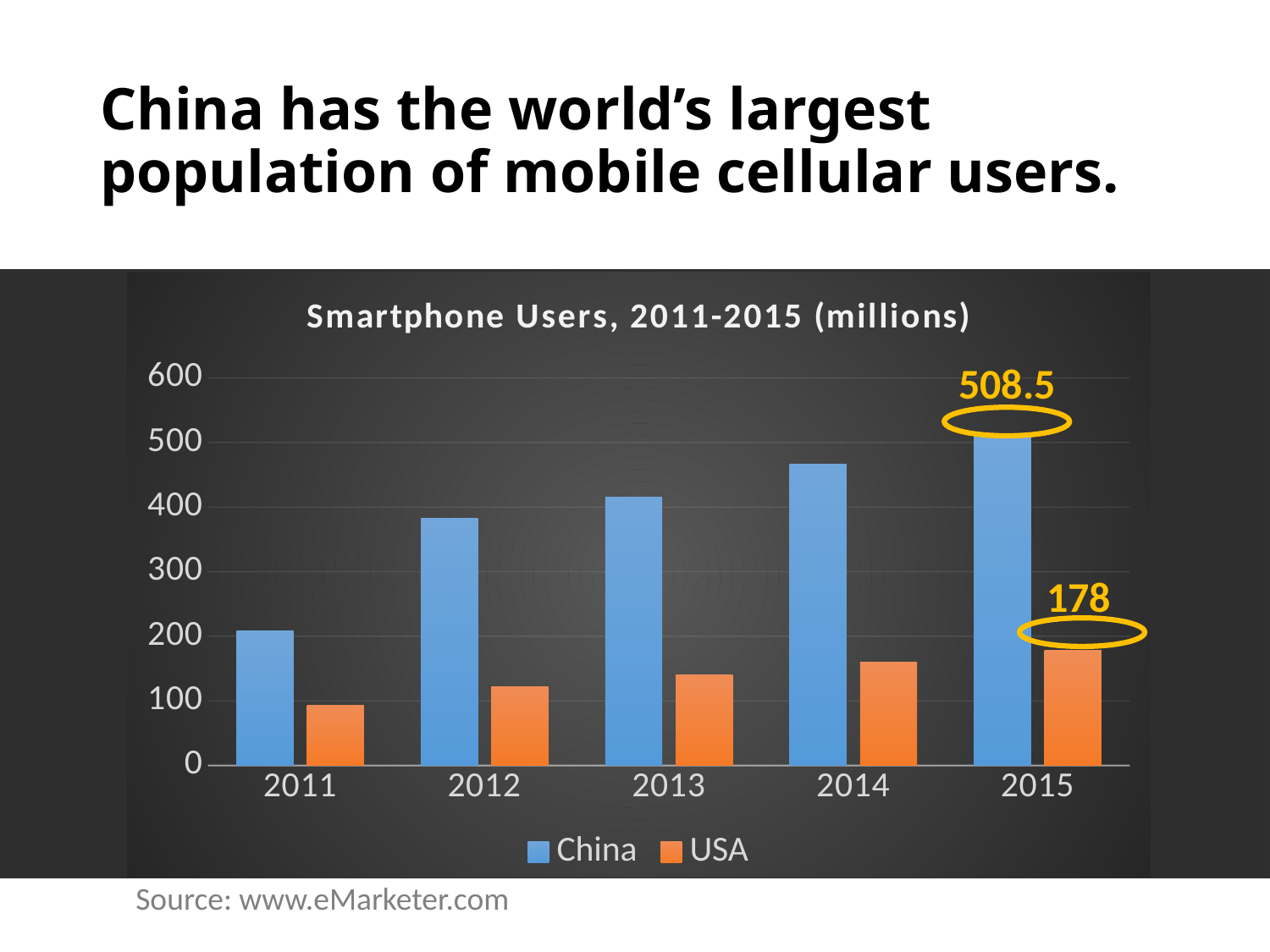
Which year has the highest value for China? 2015 Is the value for USA in 2011 greater or less than 100? less Is the value for China in 2012 greater or less than 300? greater What is the value for China in 2015? 508.5 What is the difference between the China and USA values in 2015? 330.5 Which is larger in 2013, the value for China or the value for USA? China Do the values for China rise or fall from 2011 to 2015? Rise What is the value for USA in 2015? 178 Which year has the lowest value for USA? 2011 How many series does the legend list? 2 What kind of chart is shown on the slide? Bar chart How many years are shown on the x axis? 5